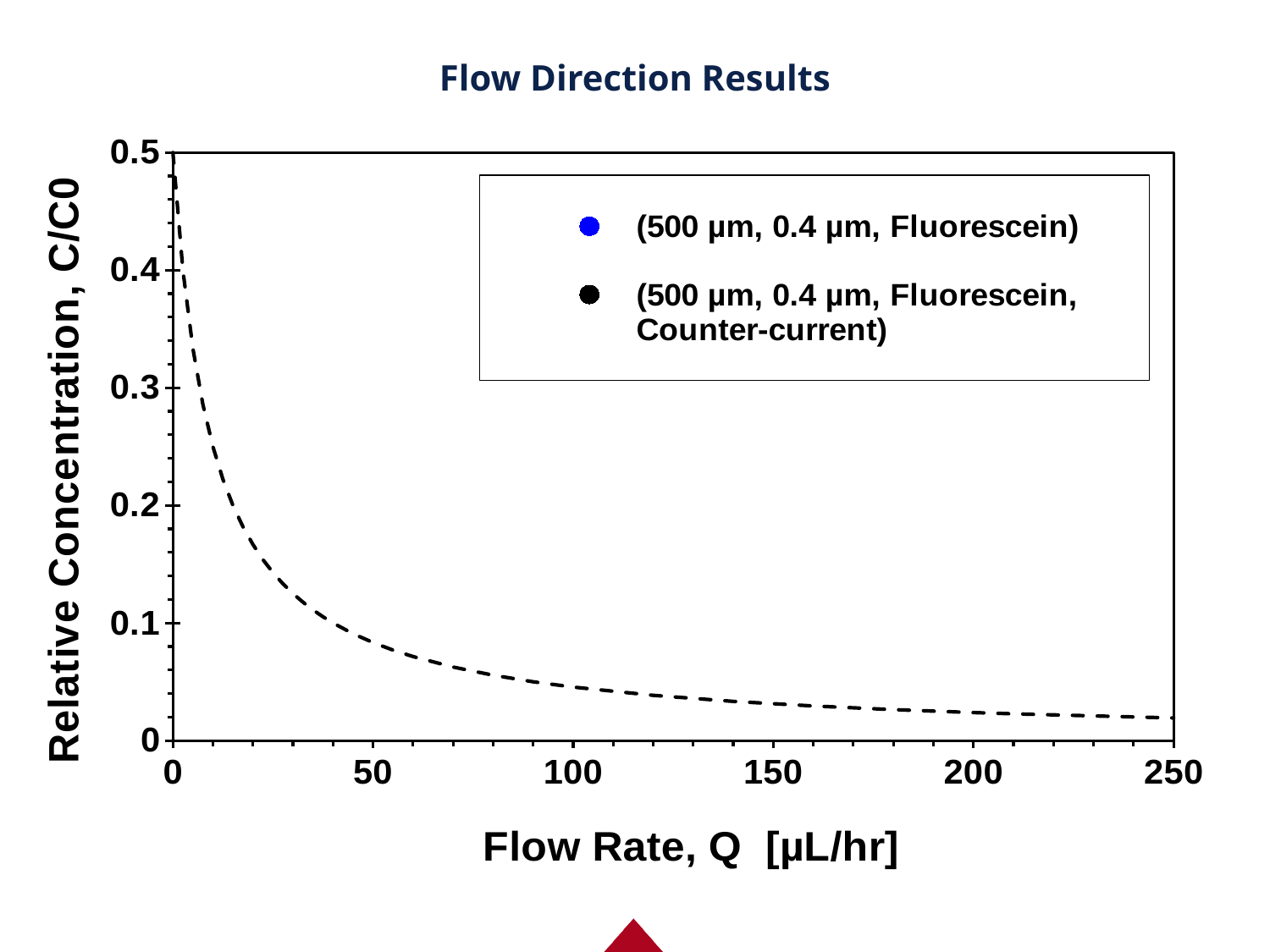
What kind of chart is shown on the slide? line chart Is the relative concentration at a flow rate of 200 µL/hr greater or less than 0.1? less Does the relative concentration rise or fall as the flow rate increases? fall Is the relative concentration at a flow rate of 25 µL/hr greater or less than 0.1? greater Is the relative concentration at a flow rate of 250 µL/hr greater or less than 0.1? less How many series does the legend list? 2 What is the title of the chart? Flow Direction Results What is the label of the x axis? Flow Rate, Q [µL/hr]